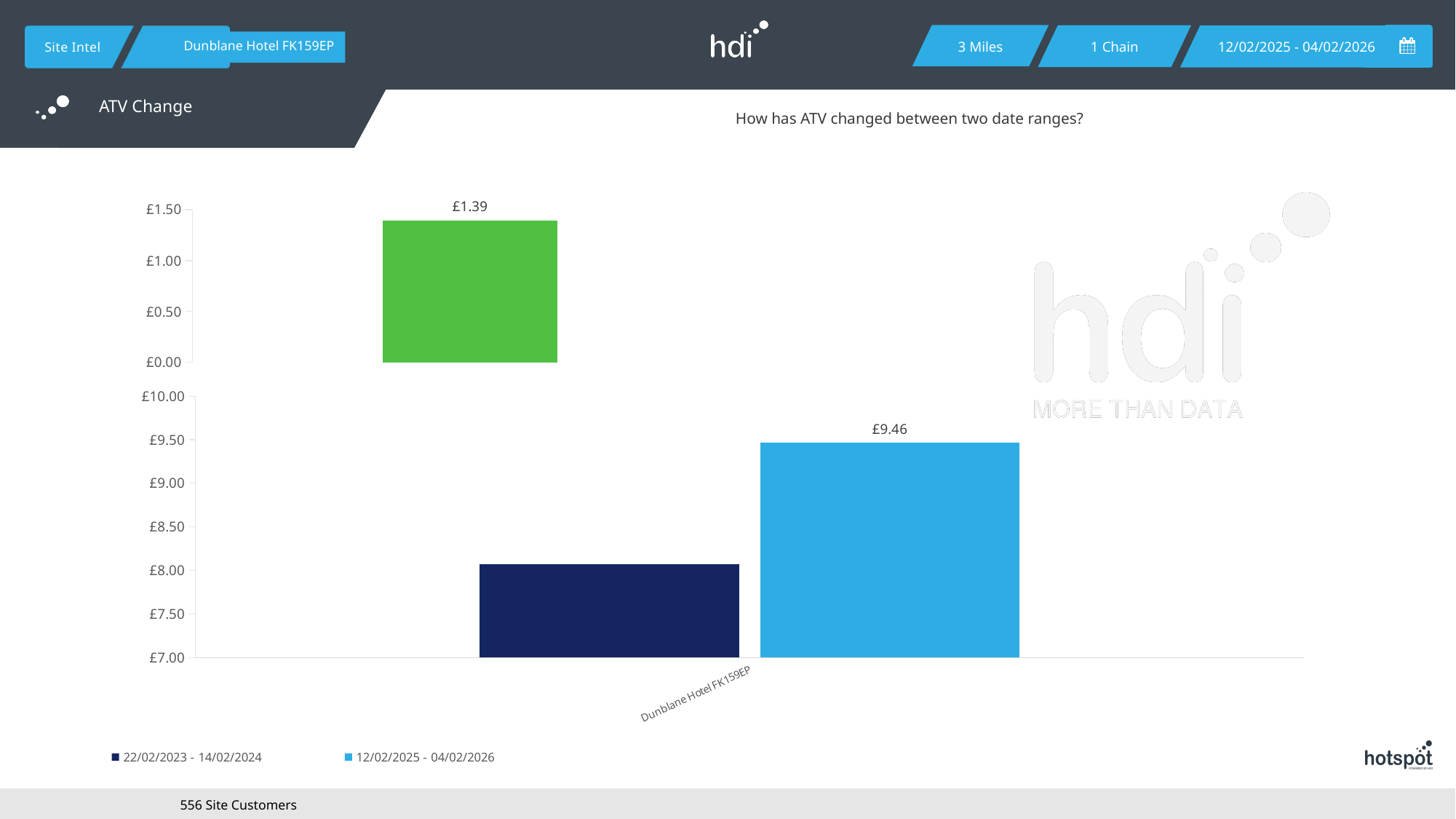
How many categories are shown on the x axis of the bottom chart? 1 In the bottom chart, is the value for the 22/02/2023 - 14/02/2024 series greater or less than £7.50? greater What kind of chart is the bottom chart? bar chart What is the title shown in the header of the slide for this chart? ATV Change How many series does the legend at the bottom of the slide list? 2 What is the category label on the x axis of the bottom chart? Dunblane Hotel FK159EP In the top chart, what value is printed on the green bar? £1.39 In the bottom chart, is the value for the 22/02/2023 - 14/02/2024 series greater or less than £8.50? less In the bottom chart, which series has the larger value: 22/02/2023 - 14/02/2024 or 12/02/2025 - 04/02/2026? 12/02/2025 - 04/02/2026 In the bottom chart, what is the value for the 12/02/2025 - 04/02/2026 series? £9.46 In the bottom chart, is the value for the 12/02/2025 - 04/02/2026 series greater or less than £9.00? greater In the bottom chart, which series has the highest bar? 12/02/2025 - 04/02/2026